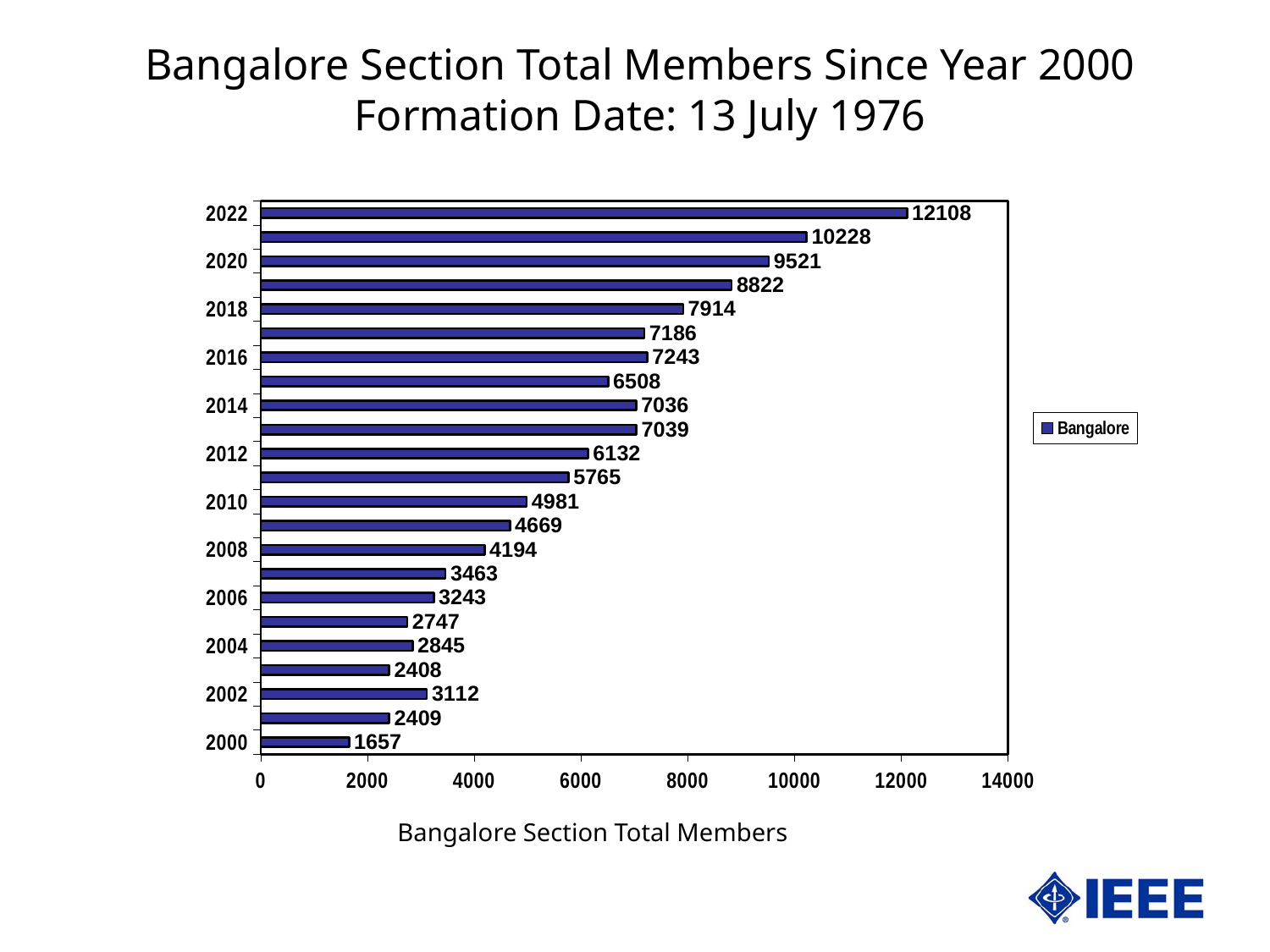
What is the value for 2018? 7914 Which year has the highest value? 2022 What is the difference between the values for 2022 and 2020? 2587 Which is larger, the value for 2002 or the value for 2004? 2002 How many bars are plotted in the chart? 23 What type of chart is shown on the slide? bar chart What is the value for 2022? 12108 What is the name of the series shown in the legend? Bangalore What is the value for 2000? 1657 What is the value for 2012? 6132 How many series does the legend list? 1 Which year has the lowest value? 2000